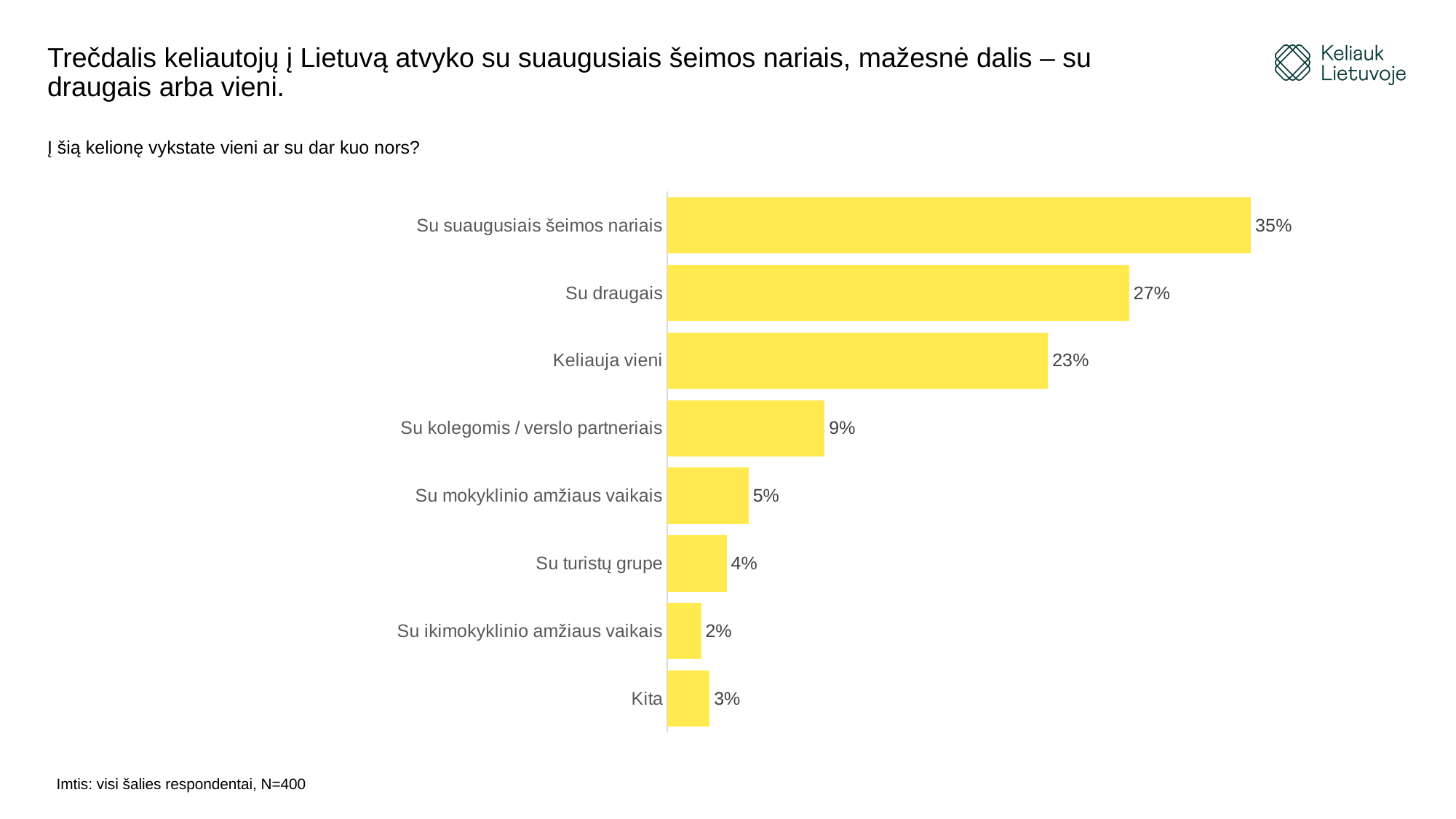
Which category has the lowest value? Su ikimokyklinio amžiaus vaikais Which is larger, the value for "Su turistų grupe" or the value for "Kita"? Su turistų grupe What is the value for "Keliauja vieni"? 23% What is the difference between the values for "Su suaugusiais šeimos nariais" and "Su kolegomis / verslo partneriais"? 26% What is the value for "Su suaugusiais šeimos nariais"? 35% What kind of chart is shown on the slide? Bar chart What is the value for "Su ikimokyklinio amžiaus vaikais"? 2% What is the difference between the values for "Su draugais" and "Keliauja vieni"? 4% How many categories are shown in the chart? 8 Which category has the highest value? Su suaugusiais šeimos nariais What is the value for "Su kolegomis / verslo partneriais"? 9% What colour are the bars in the chart? Yellow